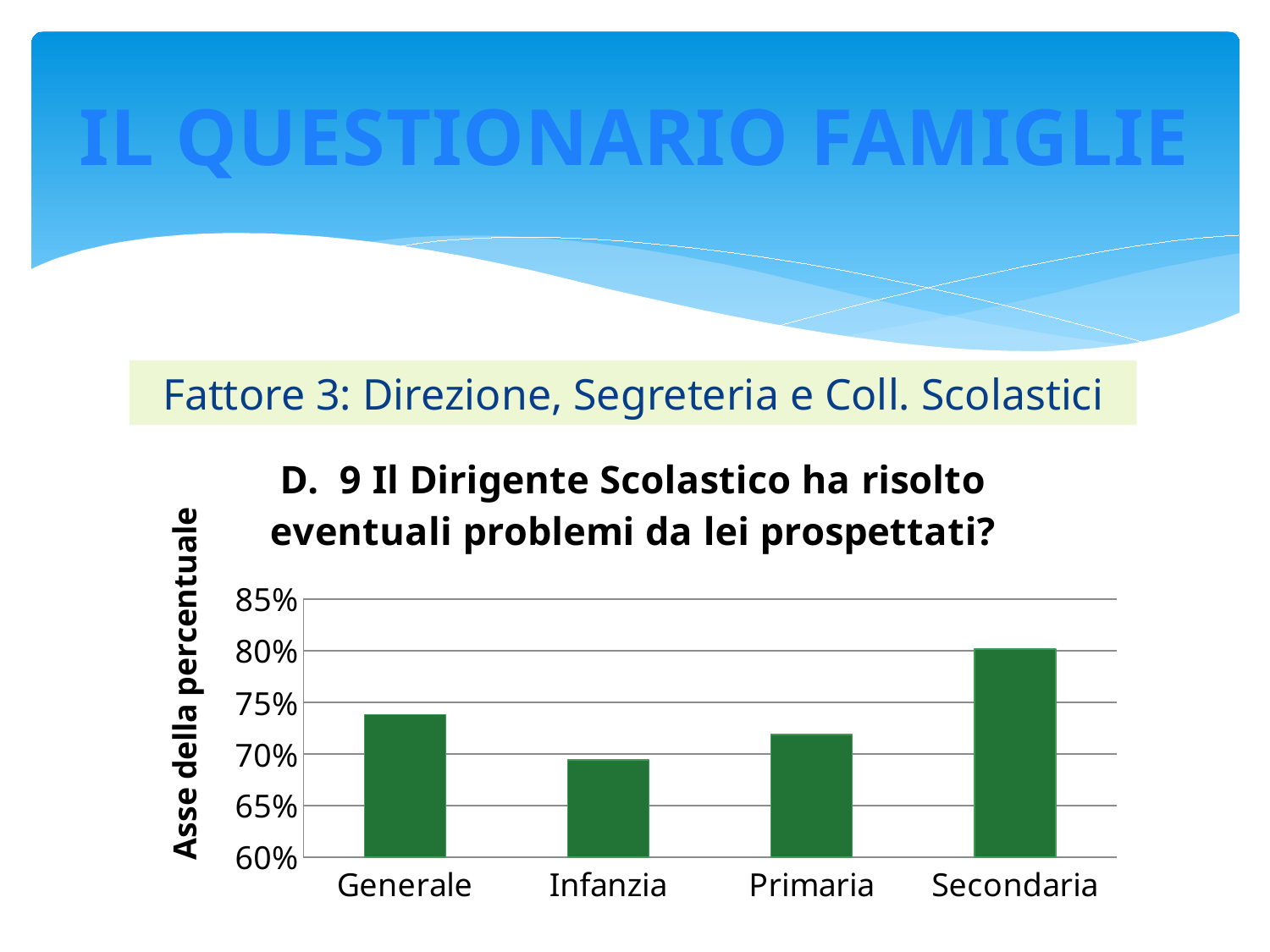
Is the value for Secondaria greater or less than 75%? greater Which category has the lowest value in the chart? Infanzia What is the label of the vertical axis of the chart? Asse della percentuale Is the value for Infanzia greater or less than 75%? less What is the title of the chart? D. 9 Il Dirigente Scolastico ha risolto eventuali problemi da lei prospettati? Is the value for Generale greater or less than 80%? less How many categories are shown on the x axis of the chart? 4 Which is larger, the value for Secondaria or the value for Infanzia? Secondaria Which category has the highest value in the chart? Secondaria What kind of chart is shown on the slide? bar chart